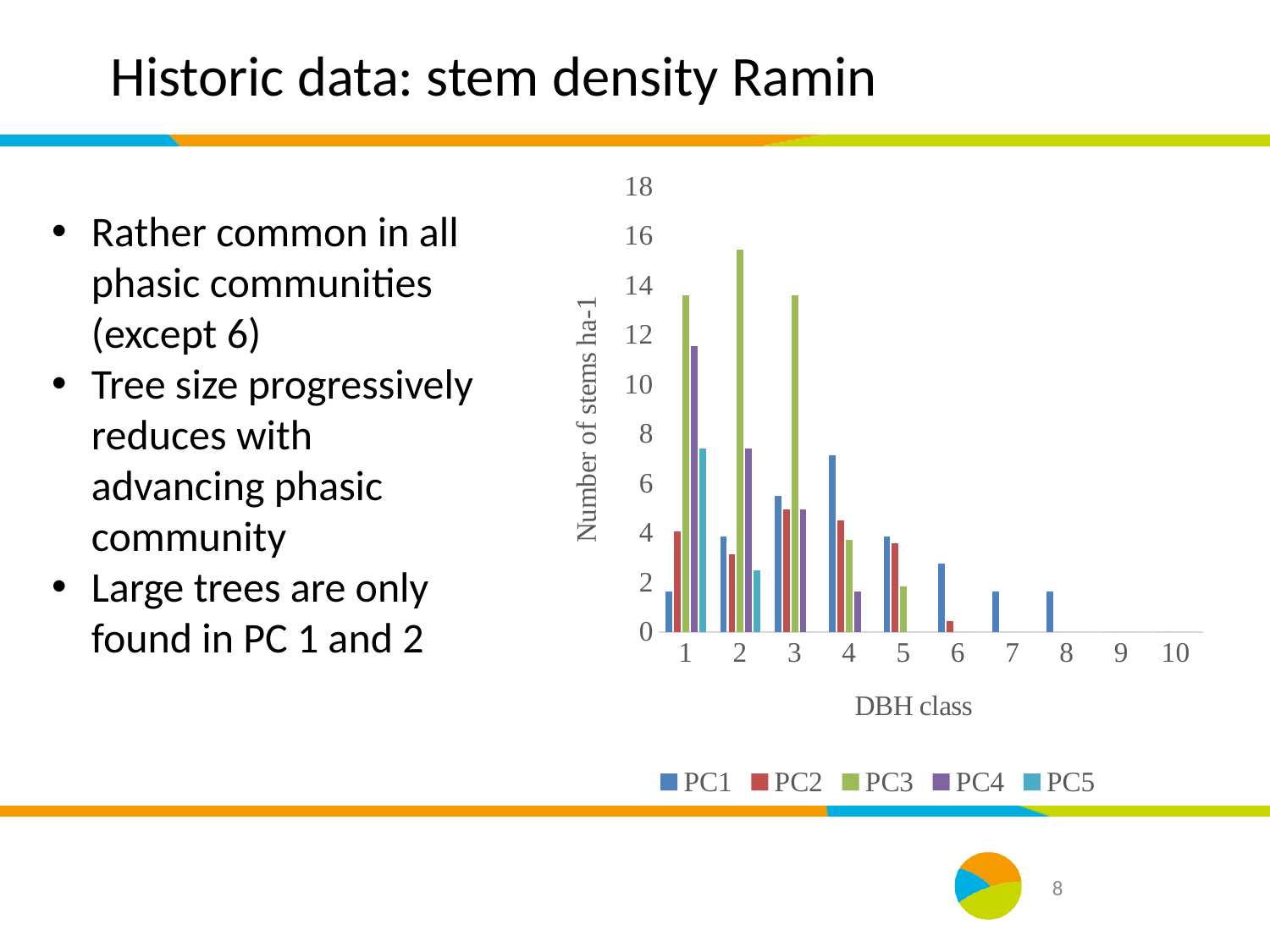
At DBH class 4, which is larger, PC1 or PC2? PC1 How many series does the legend list? 5 At DBH class 1, which is larger, PC3 or PC4? PC3 Which series has the tallest bar in the chart? PC3 How many DBH classes are shown on the x axis? 10 Is the value for PC5 at DBH class 1 greater or less than 6? greater Is the value for PC3 at DBH class 2 greater or less than 14? greater What kind of chart is shown on the slide? bar chart What is the title of the y axis? Number of stems ha-1 Which series is the only one with bars at DBH classes 7 and 8? PC1 Is the value for PC1 at DBH class 6 greater or less than 2? greater